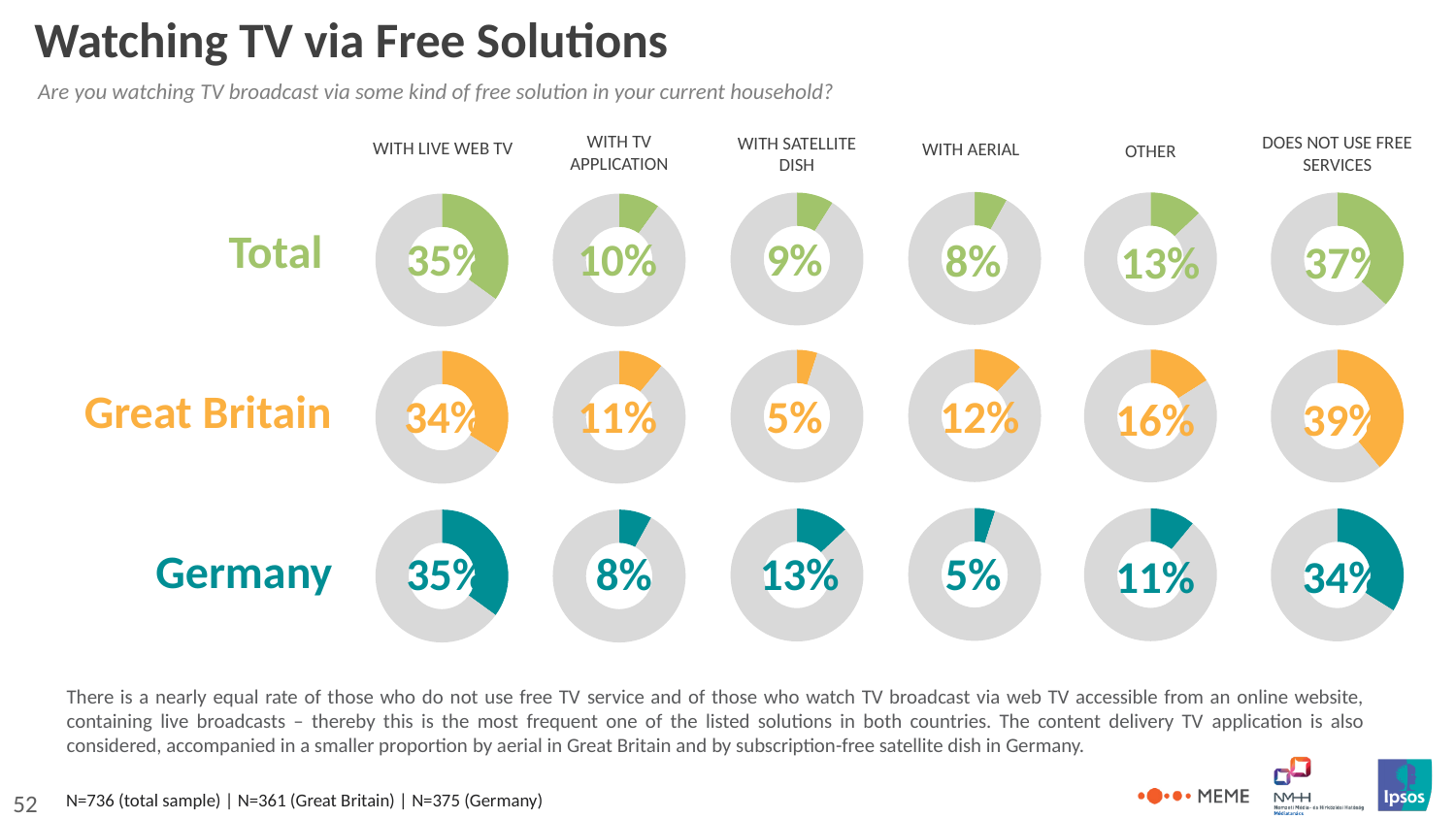
What is the value for Germany in the 'With satellite dish' donut chart? 13% What is the difference between the Total values for 'Does not use free services' and 'With live web TV'? 2% In the Great Britain row, what is the value for 'Does not use free services'? 39% Among the Total donut charts, which category has the highest value? Does not use free services In the Great Britain row, what is the value for 'With aerial'? 12% What percentage of the Total sample watches TV with live web TV? 35% How many categories (columns of donut charts) are shown on the slide? 6 What is the difference between Great Britain and Germany for 'Other'? 5% What type of chart is used to display the values on this slide? Donut (pie) chart Which is larger for 'With satellite dish': Great Britain or Germany? Germany Among the Germany donut charts, which category has the lowest value? With aerial What colour are the Germany donut chart segments? Teal